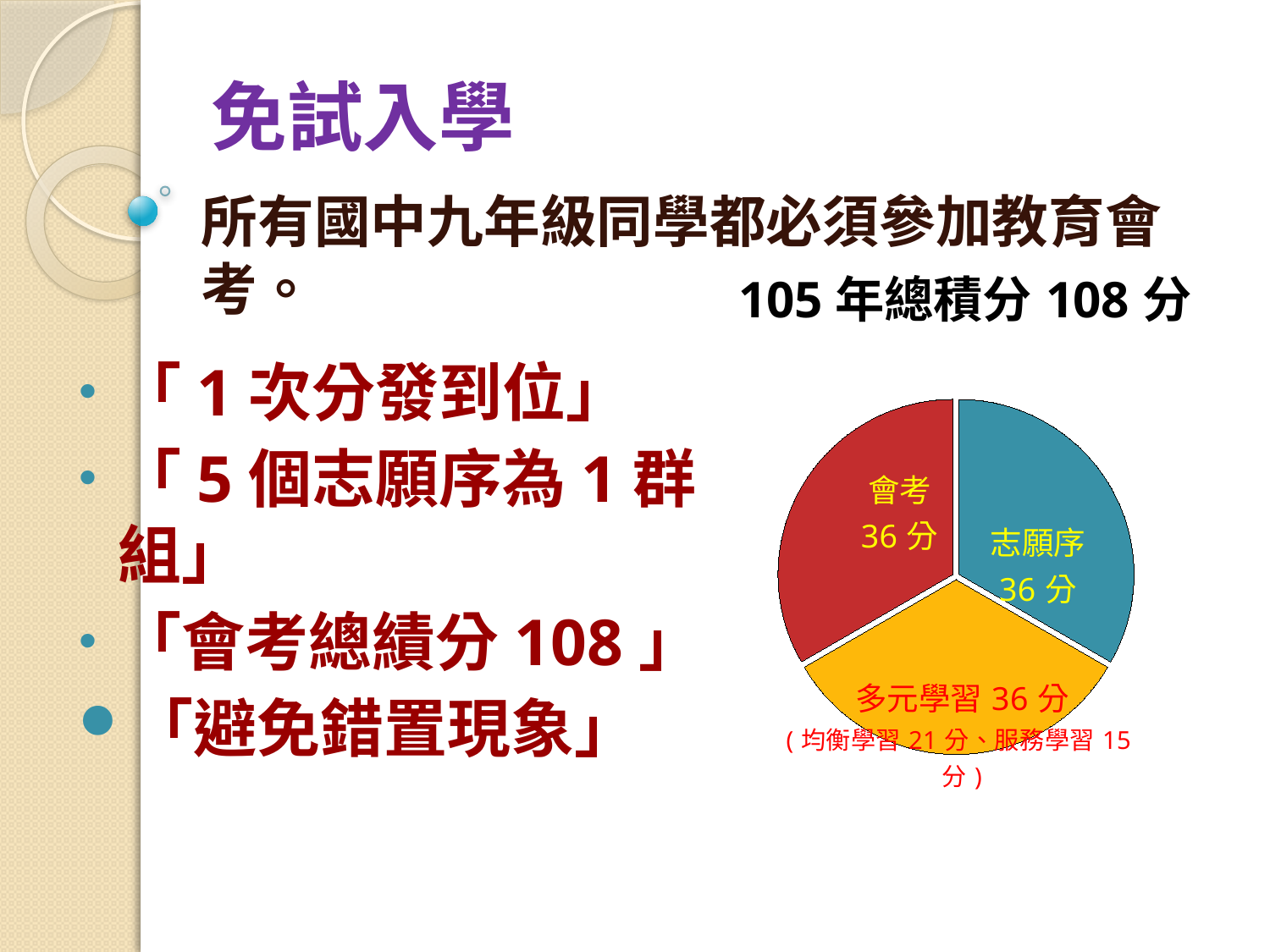
What is the value shown for the 會考 slice? 36 分 What is the total of the three slices in the pie chart? 108 分 How many slices does the pie chart have? 3 What is the difference between the 會考 slice and the 志願序 slice? 0 分 What colour is the 會考 slice of the pie chart? red According to the label on the 多元學習 slice, how many points is 均衡學習 worth? 21 分 What is the value shown for the 志願序 slice? 36 分 What type of chart is shown on the slide? pie chart What share of the pie does the 會考 slice represent? one third What is the value shown for the 多元學習 slice? 36 分 According to the label on the 多元學習 slice, how many points is 服務學習 worth? 15 分 What is the difference between the 均衡學習 points and the 服務學習 points listed under 多元學習? 6 分